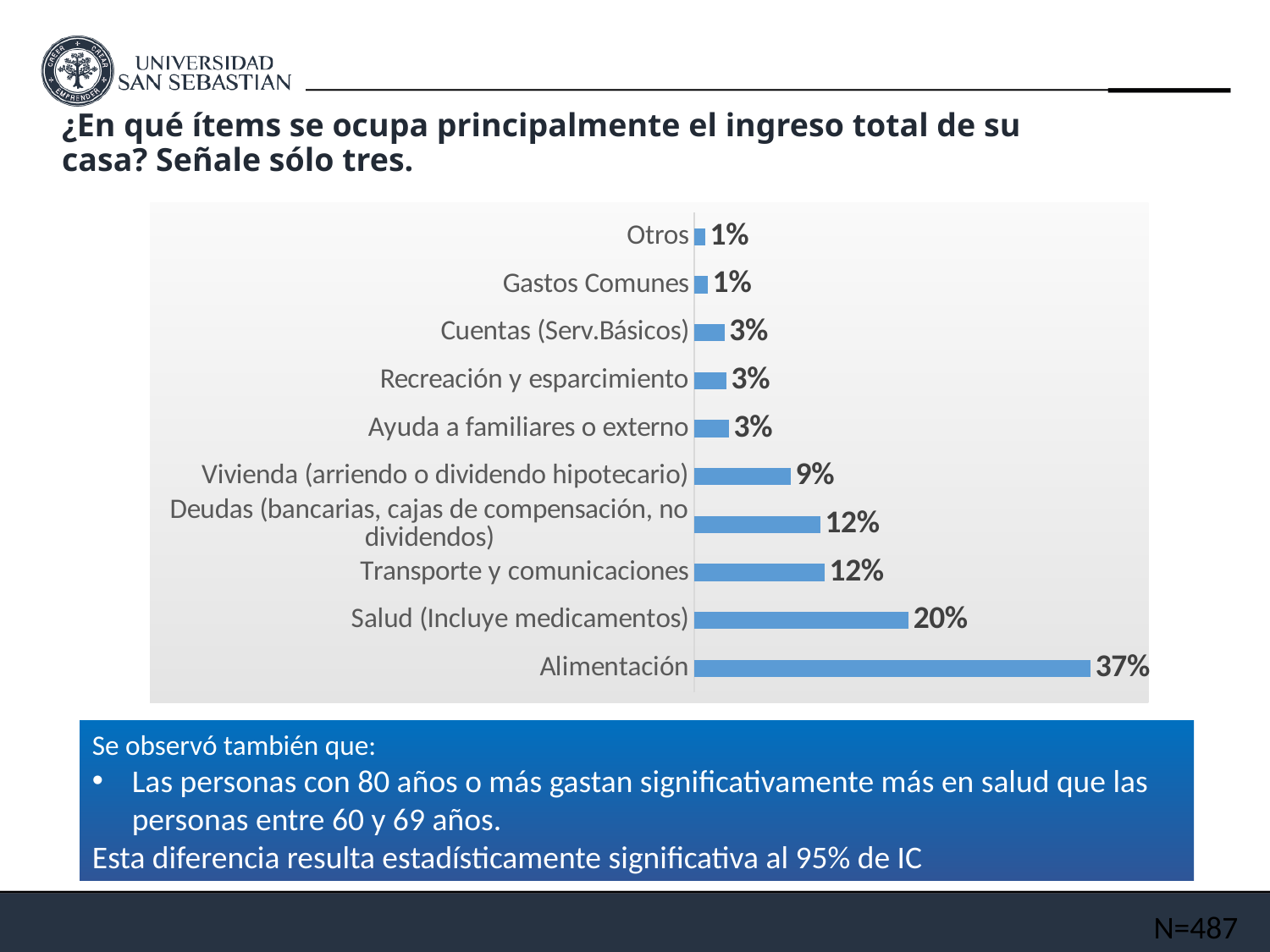
What is the value for Gastos Comunes? 1% What is the difference between the values for Alimentación and Salud (Incluye medicamentos)? 17% Which is larger, the value for Salud (Incluye medicamentos) or the value for Transporte y comunicaciones? Salud (Incluye medicamentos) Which category has the highest value? Alimentación What is the difference between the values for Transporte y comunicaciones and Vivienda (arriendo o dividendo hipotecario)? 3% How many categories are shown in the chart? 10 What is the value for Alimentación? 37% What is the value for Salud (Incluye medicamentos)? 20% What kind of chart is shown on the slide? Bar chart What is the sample size (N) shown on the slide? N=487 What value is shown for Deudas (bancarias, cajas de compensación, no dividendos)? 12% What is the value for Vivienda (arriendo o dividendo hipotecario)? 9%